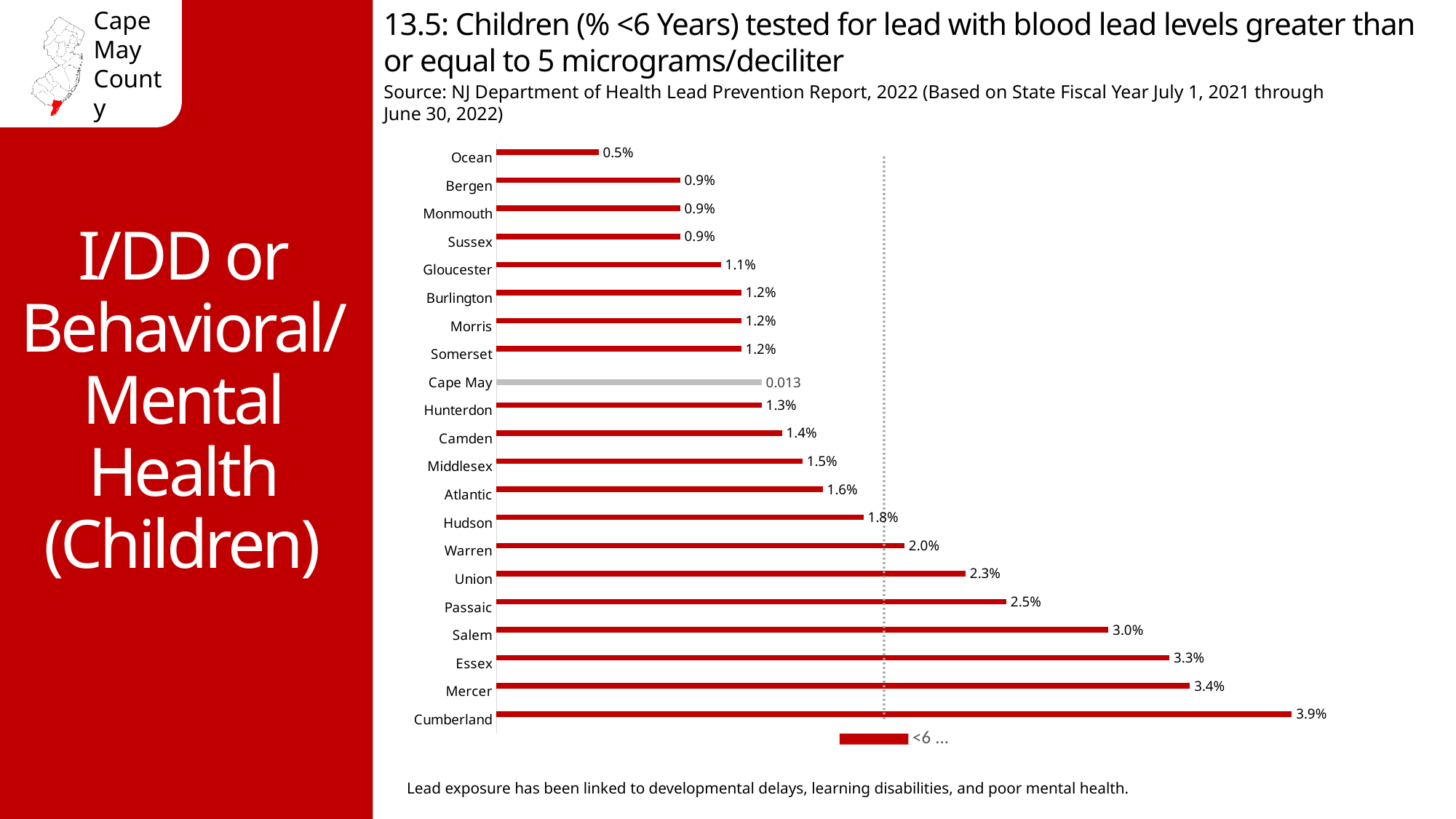
Which county has the lowest value? Ocean What is the difference between the values for Cumberland and Ocean? 3.4 percentage points How many counties are shown in the chart? 21 What kind of chart is shown on the slide? Bar chart What is the difference between the values for Mercer and Essex? 0.1 percentage points What value is shown for Cape May? 0.013 What is the value for Cumberland? 3.9% Which county has the highest value? Cumberland What is the value for Salem? 3.0% What colour is the bar for Cape May? Gray What is the value for Ocean? 0.5% Which is larger, the value for Passaic or the value for Union? Passaic